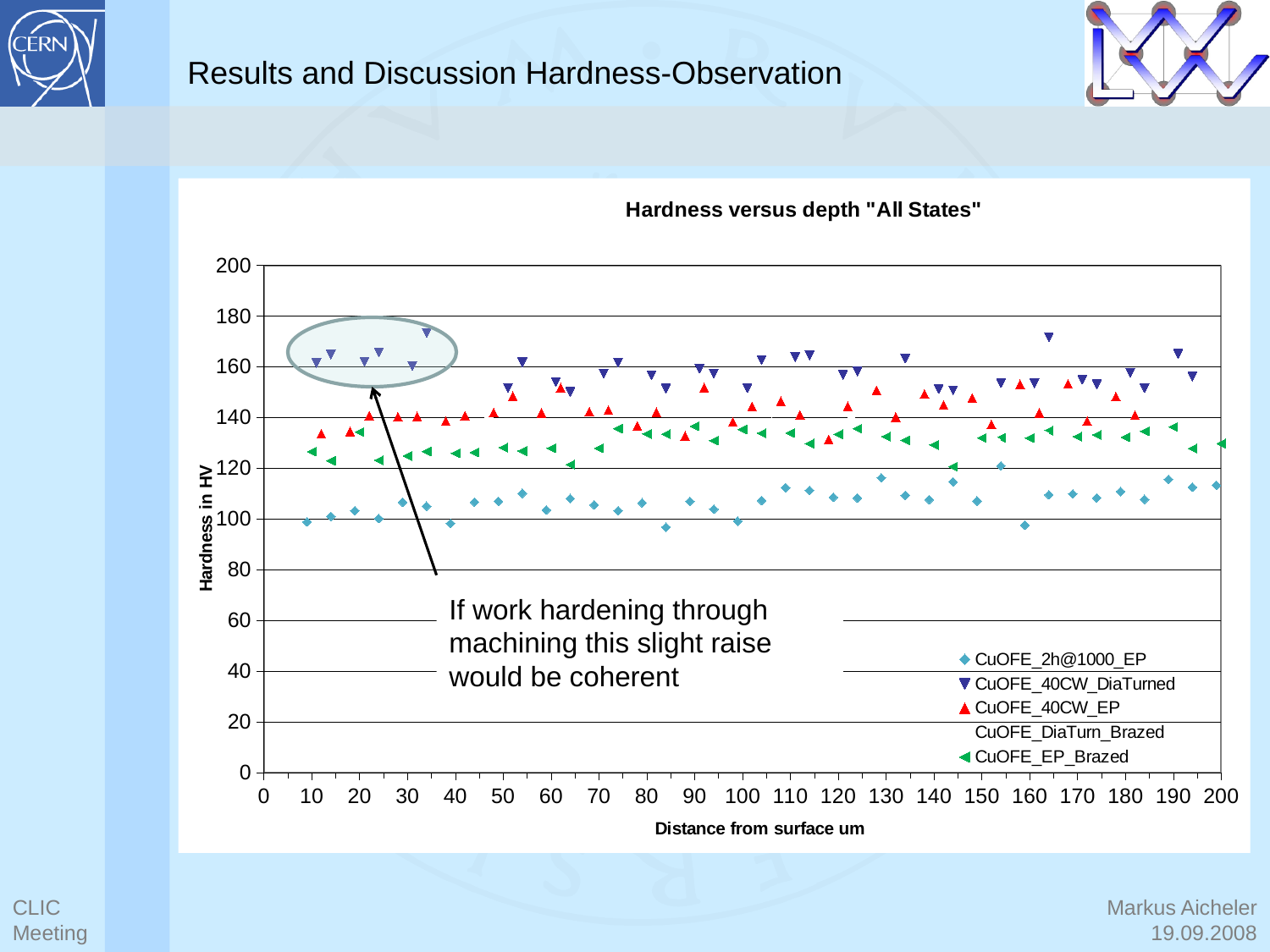
Which series has the lowest hardness values across the depth range? CuOFE_2h@1000_EP What is the title of the chart? Hardness versus depth "All States" Is the value for CuOFE_40CW_EP at about 20 um greater or less than 120? greater How many series does the legend list? 5 Which series has the highest hardness values across the depth range? CuOFE_40CW_DiaTurned Is the highest value for CuOFE_40CW_DiaTurned (near 35 um) greater or less than 160? greater Is the value for CuOFE_EP_Brazed at about 10 um greater or less than 140? less What kind of chart is shown on the slide? scatter chart What is the label of the vertical axis? Hardness in HV Which series has higher hardness values overall, CuOFE_40CW_DiaTurned or CuOFE_2h@1000_EP? CuOFE_40CW_DiaTurned